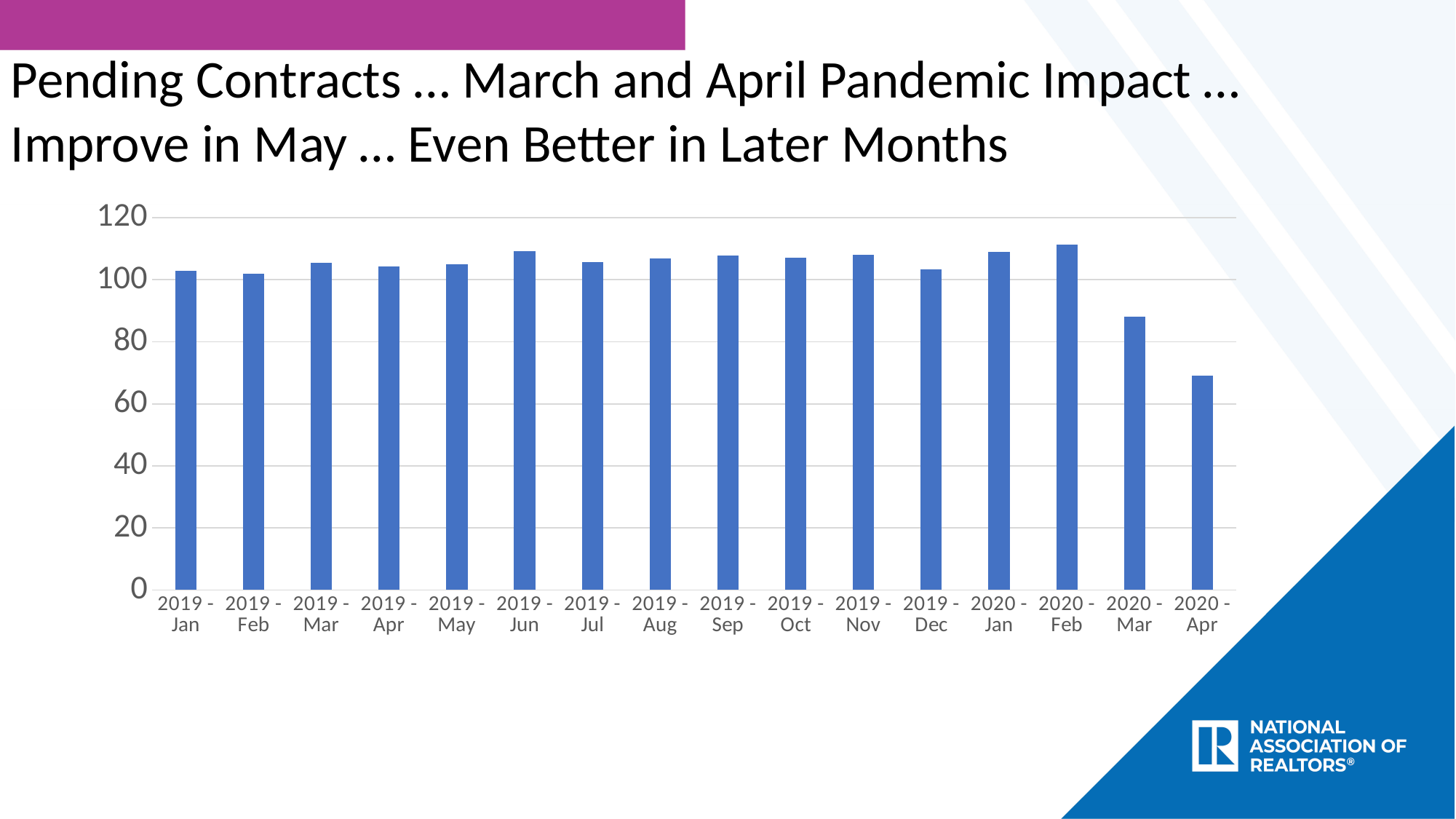
Is the value for 2020 - Mar greater or less than 80? greater What is the highest value shown on the vertical axis? 120 Which is larger, the value for 2020 - Mar or the value for 2020 - Apr? 2020 - Mar How many months (bars) are plotted on the chart? 16 What kind of chart is shown on the slide? bar chart Is the value for 2020 - Mar greater or less than 100? less Which is larger, the value for 2019 - Jun or the value for 2019 - Feb? 2019 - Jun Which month has the lowest bar on the chart? 2020 - Apr Do the values rise or fall from 2020 - Feb to 2020 - Apr? fall Is the value for 2019 - Jan greater or less than 100? greater Which month has the highest bar on the chart? 2020 - Feb